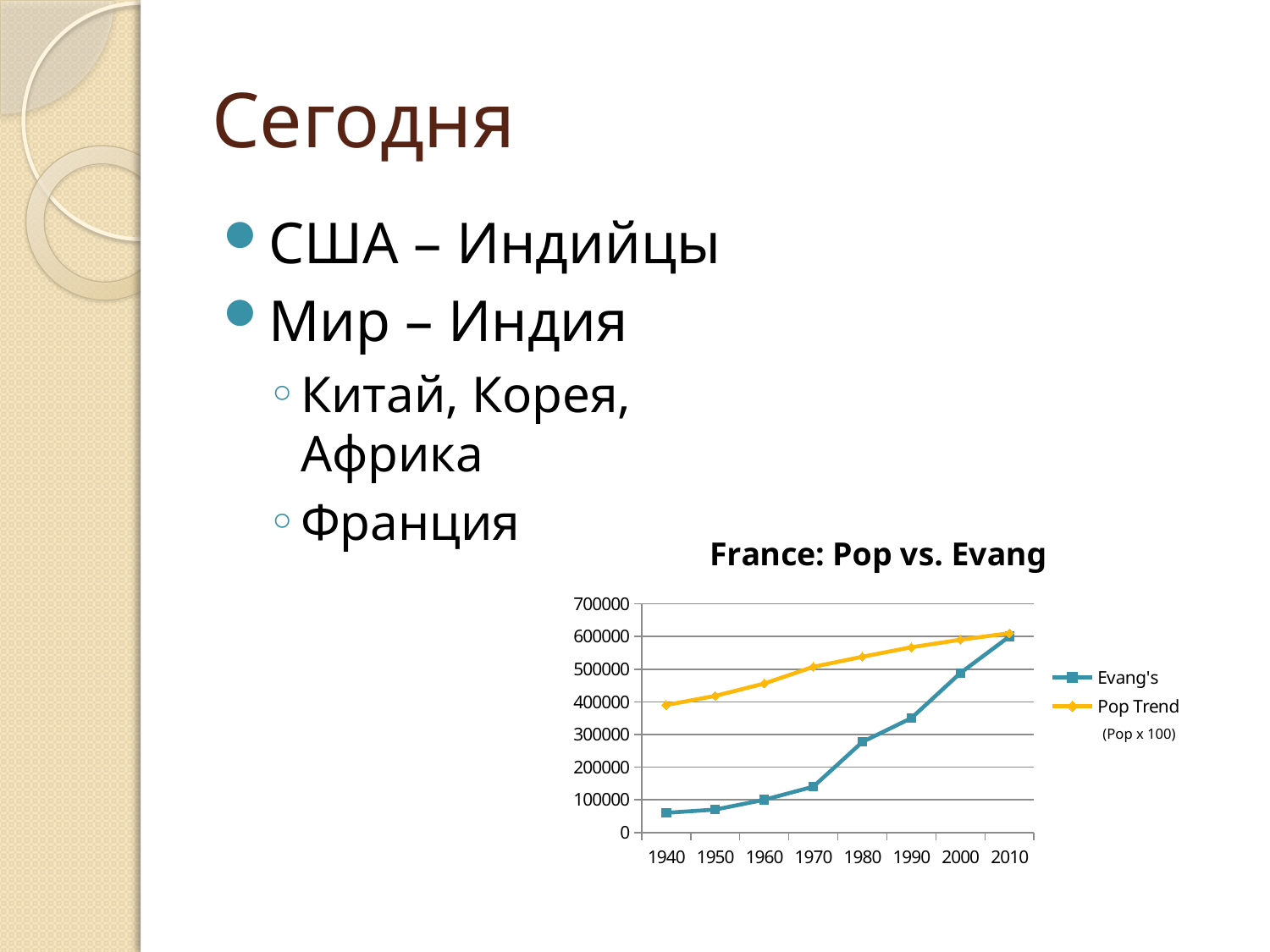
In 1940, which series has the larger value, Evang's or Pop Trend? Pop Trend Does the Pop Trend series rise or fall from 1940 to 2010? rise How many years are plotted along the x axis of the chart? 8 In which year is the Evang's series at its lowest? 1940 Is the Pop Trend value for 1960 greater or less than 500000? less What is the title of the chart? France: Pop vs. Evang In which year is the Pop Trend series at its highest? 2010 Is the Evang's value for 1940 greater or less than 100000? less Is the Evang's value for 1990 greater or less than 300000? greater How many series does the chart legend list? 2 Does the Evang's series rise or fall from 1940 to 2010? rise What kind of chart is shown on the slide? line chart